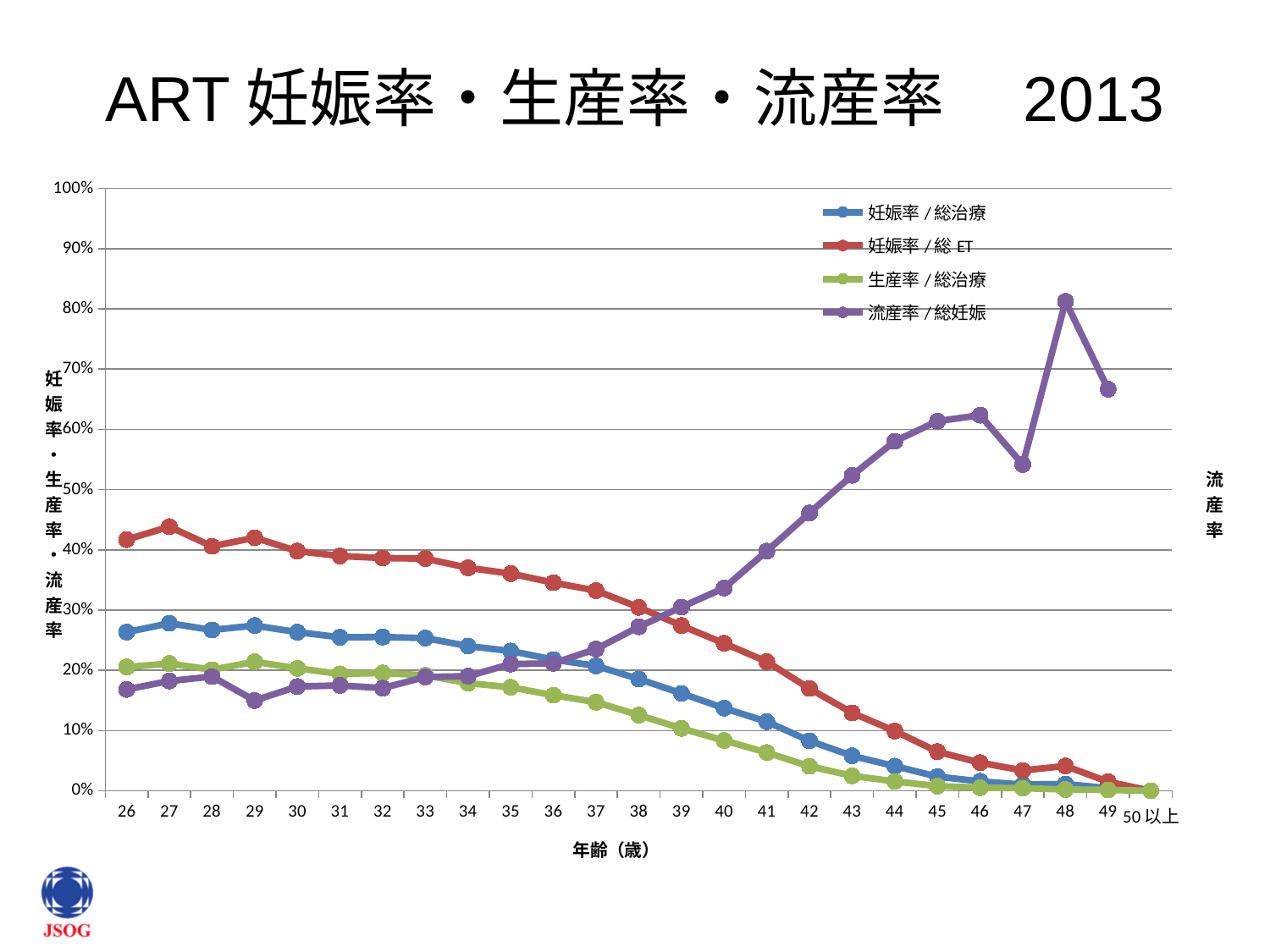
Is the value of 妊娠率 / 総 ET at age 26 greater or less than 40%? greater Does the 流産率 / 総妊娠 series generally rise or fall as age increases from 26 to 48? rise At age 40, which is larger: 妊娠率 / 総 ET or 流産率 / 総妊娠? 流産率 / 総妊娠 At which age does the 流産率 / 総妊娠 series reach its highest value? 48 Which series is drawn in purple? 流産率 / 総妊娠 Is the value of 生産率 / 総治療 at age 40 greater or less than 10%? less How many series does the legend list? 4 How many age categories are plotted along the x axis? 25 Is the value of 流産率 / 総妊娠 at age 47 greater or less than 50%? greater Does the 妊娠率 / 総 ET series rise or fall as age increases along the x axis? fall What kind of chart is shown on the slide? line chart What is the title of the chart on the slide? ART 妊娠率・生産率・流産率 2013